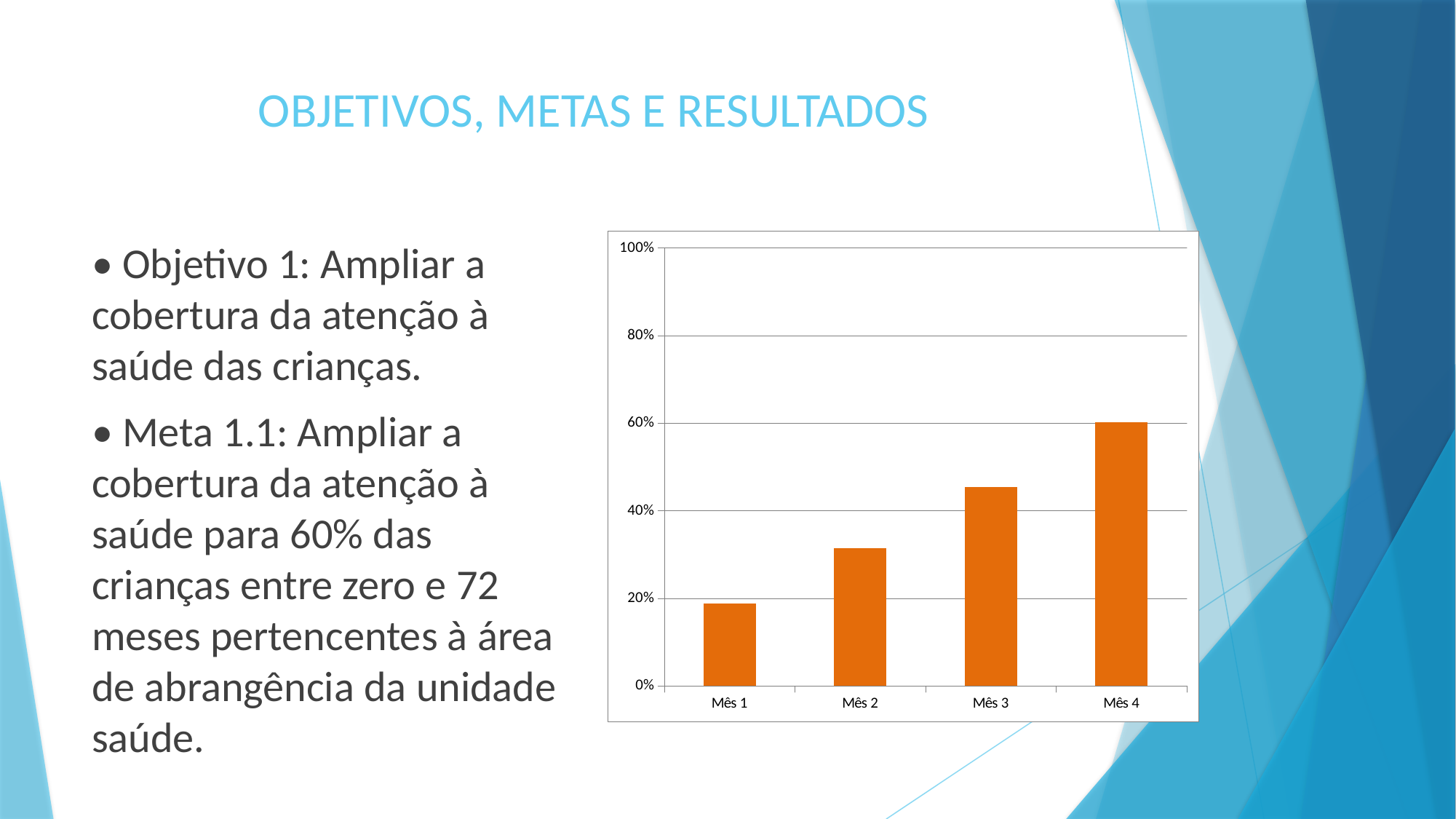
Is the value for Mês 2 greater or less than 40%? less Which month has the highest bar in the chart? Mês 4 Is the value for Mês 1 greater or less than 20%? less Which month has the lowest bar in the chart? Mês 1 How many categories are plotted on the x axis of the chart? 4 Which is larger, the value for Mês 3 or the value for Mês 2? Mês 3 What colour are the bars in the chart? orange Is the value for Mês 3 greater or less than 60%? less What kind of chart is shown on the slide? bar chart Do the values rise or fall from Mês 1 to Mês 4? rise